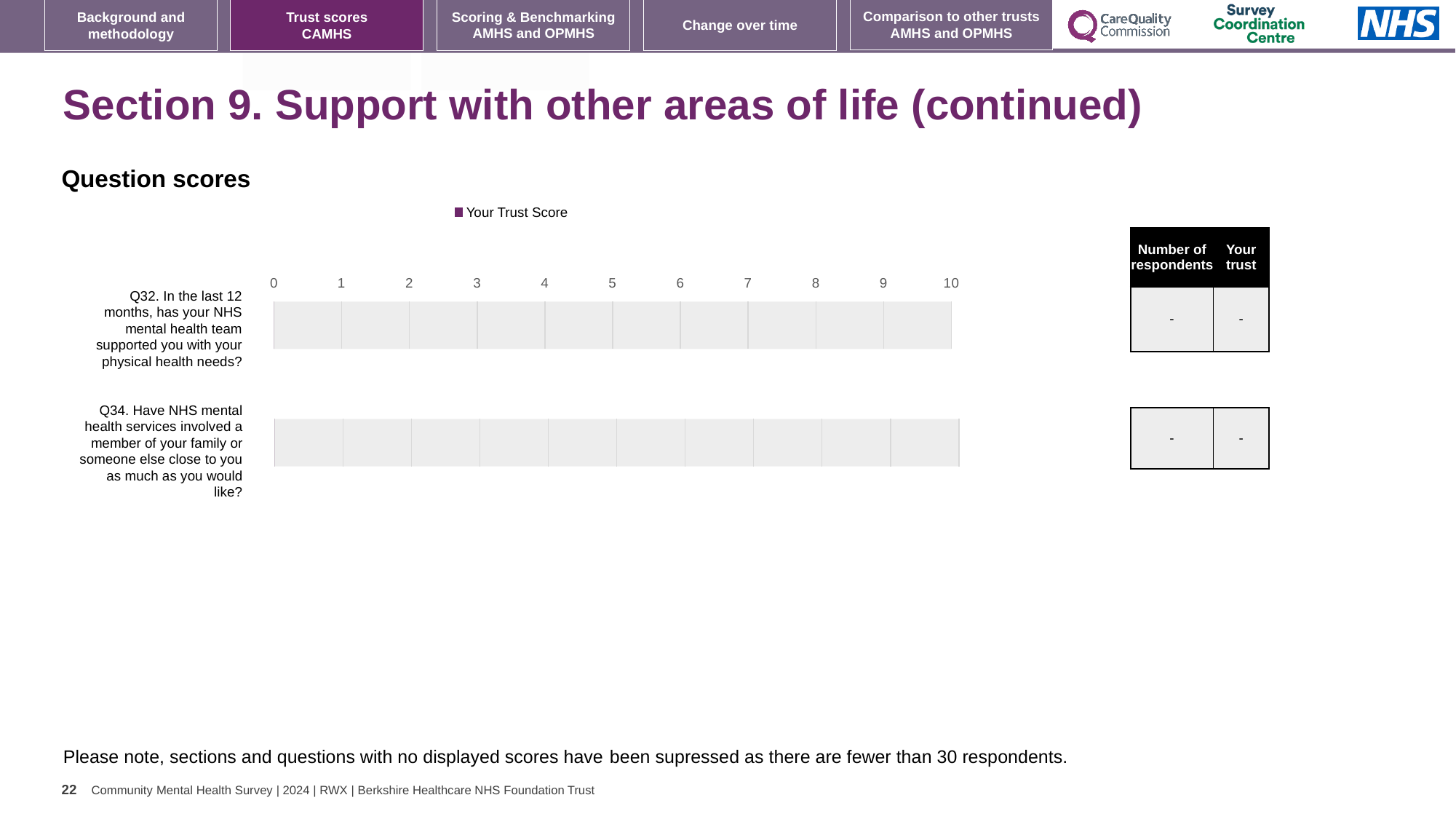
How many series does the chart legend list? 1 What value is shown in the 'Number of respondents' column of the table for Q34? - What value is shown in the 'Your trust' column of the table for Q32? - What kind of chart is shown under 'Question scores'? bar chart What is the maximum value shown on the chart's x axis? 10 What is the name of the series shown in the chart legend? Your Trust Score How many questions (categories) are listed on the chart? 2